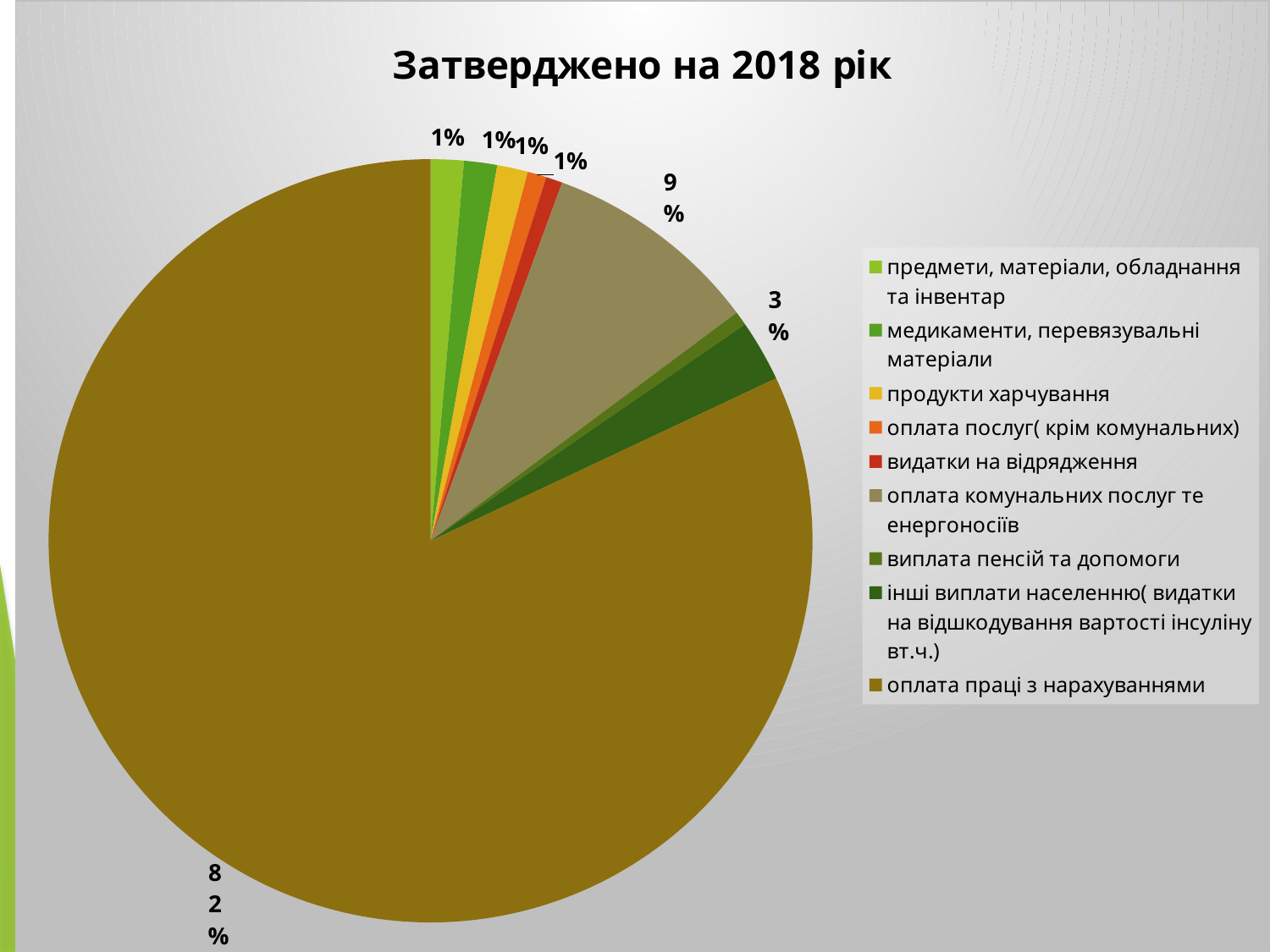
Which is larger: "оплата комунальних послуг те енергоносіїв" or "інші виплати населенню( видатки на відшкодування вартості інсуліну вт.ч.)"? оплата комунальних послуг те енергоносіїв What is the value for "предмети, матеріали, обладнання та інвентар"? 1% What is the value for "інші виплати населенню( видатки на відшкодування вартості інсуліну вт.ч.)"? 3% What colour is the slice for "оплата праці з нарахуваннями"? dark yellow (olive brown) How many categories does the legend list? 9 What share of the pie is "оплата праці з нарахуваннями"? 82% What kind of chart is shown on the slide? pie chart What is the value for "оплата комунальних послуг те енергоносіїв"? 9% What is the difference in percentage points between "оплата праці з нарахуваннями" and "оплата комунальних послуг те енергоносіїв"? 73 What is the value for "медикаменти, перевязувальні матеріали"? 1% Which category has the largest slice of the pie? оплата праці з нарахуваннями What is the title of the chart? Затверджено на 2018 рік